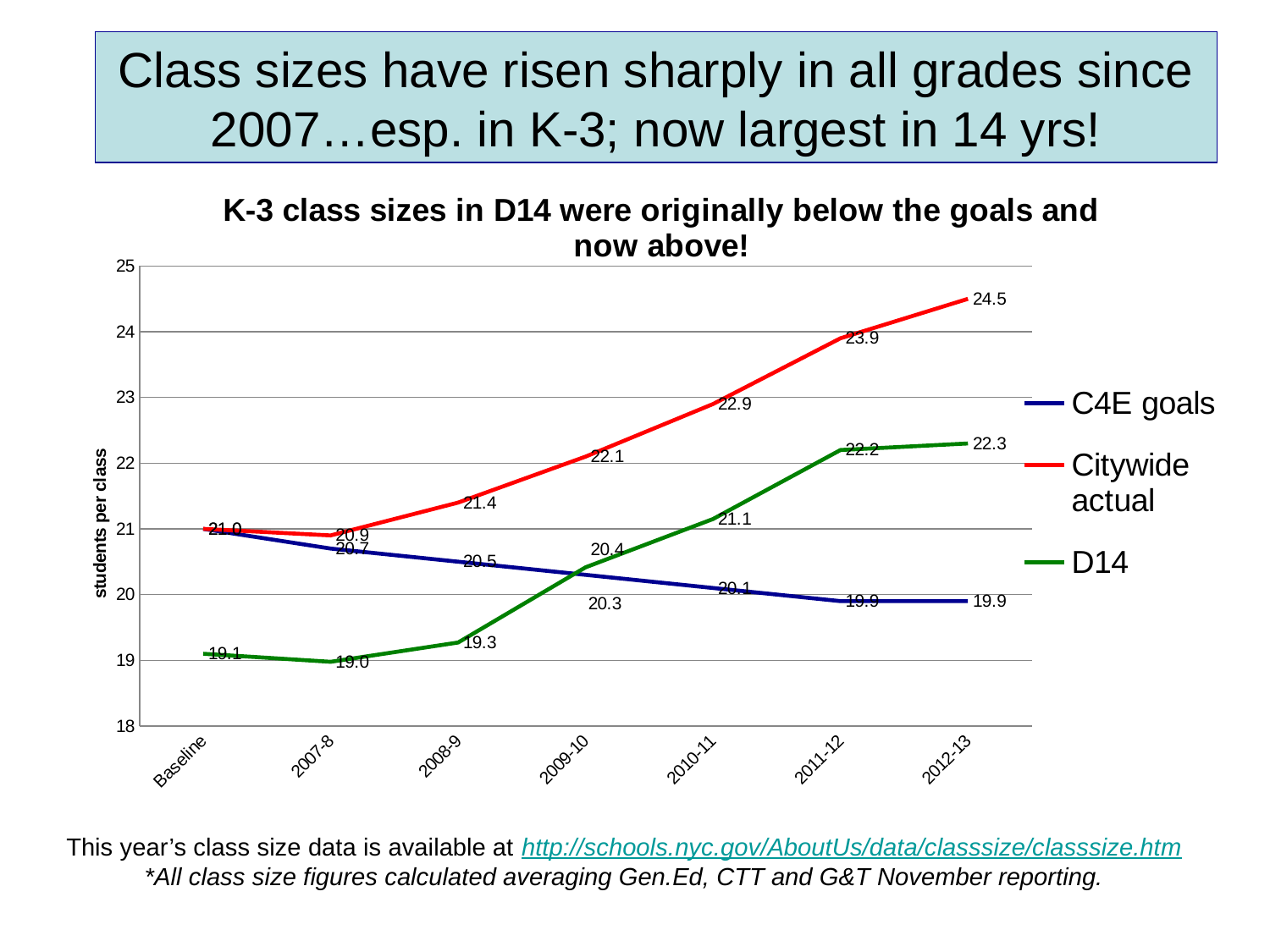
What is the Citywide actual value for 2010-11? 22.9 What is the Citywide actual value for 2012-13? 24.5 What is the D14 value for 2012-13? 22.3 What kind of chart is shown on the slide? Line chart What is the difference between the Citywide actual and D14 values in 2012-13? 2.2 What is the C4E goals value for 2012-13? 19.9 How many series does the legend list? 3 In 2011-12, which is larger: the D14 value or the C4E goals value? D14 In which year is the D14 value lowest? 2007-8 How many points are plotted along the x axis for each series? 7 What is the D14 value for 2008-9? 19.3 In which year is the Citywide actual value highest? 2012-13